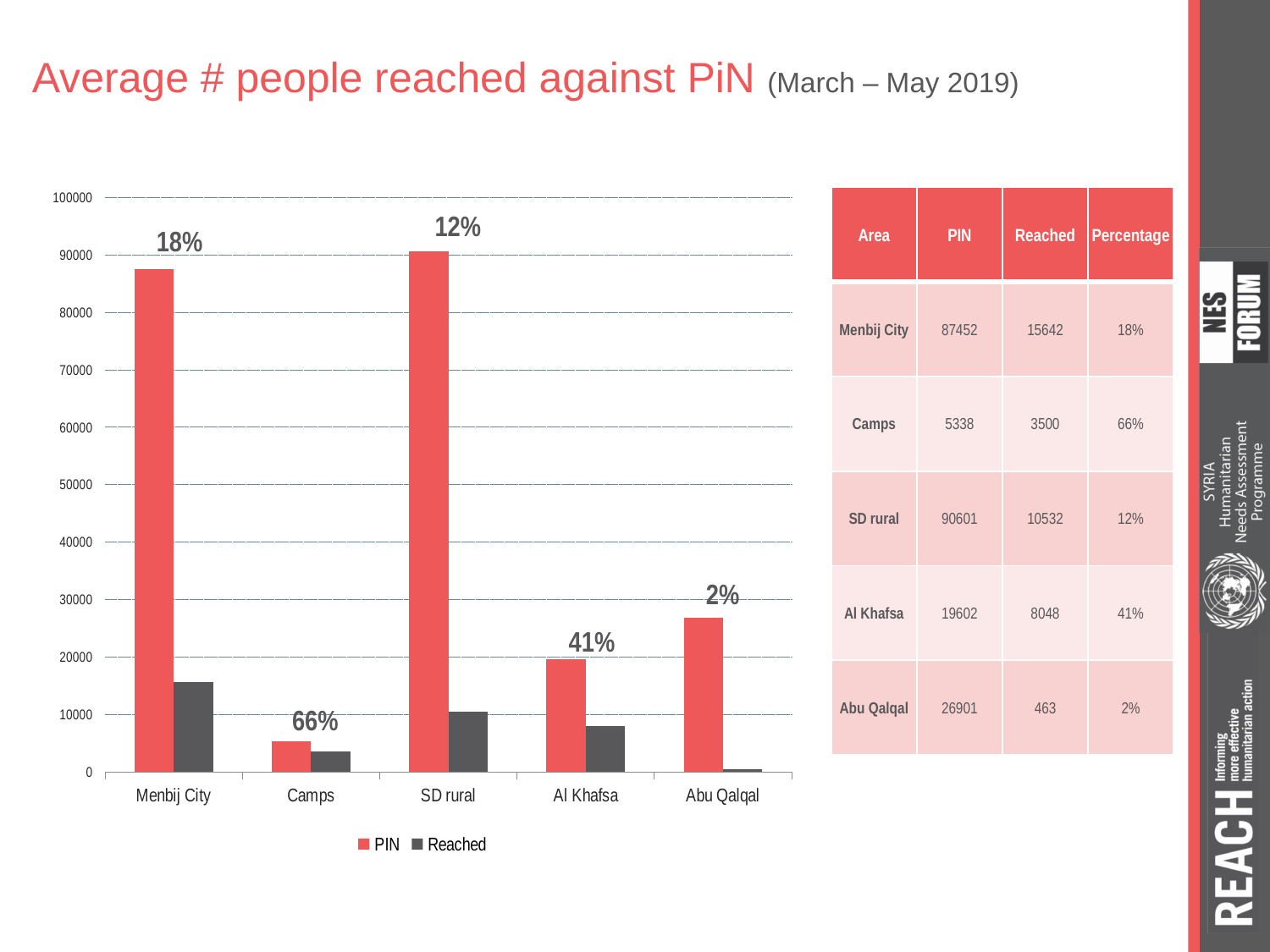
How many series does the chart's legend list? 2 Which area has the highest percentage of people reached against PIN? Camps Which is larger, the Reached value for Menbij City or for SD rural? Menbij City How many areas are shown along the x axis of the chart? 5 According to the table, what is the Reached value for Al Khafsa? 8048 What colour are the PIN bars in the chart? red Is the PIN value for Abu Qalqal greater or less than 30000? less Which area has the lowest Reached value? Abu Qalqal What percentage label is shown above the bars for Camps? 66% What kind of chart is shown on the slide? bar chart Is the Reached value for Menbij City greater or less than 20000? less What percentage label is shown above the bars for SD rural? 12%